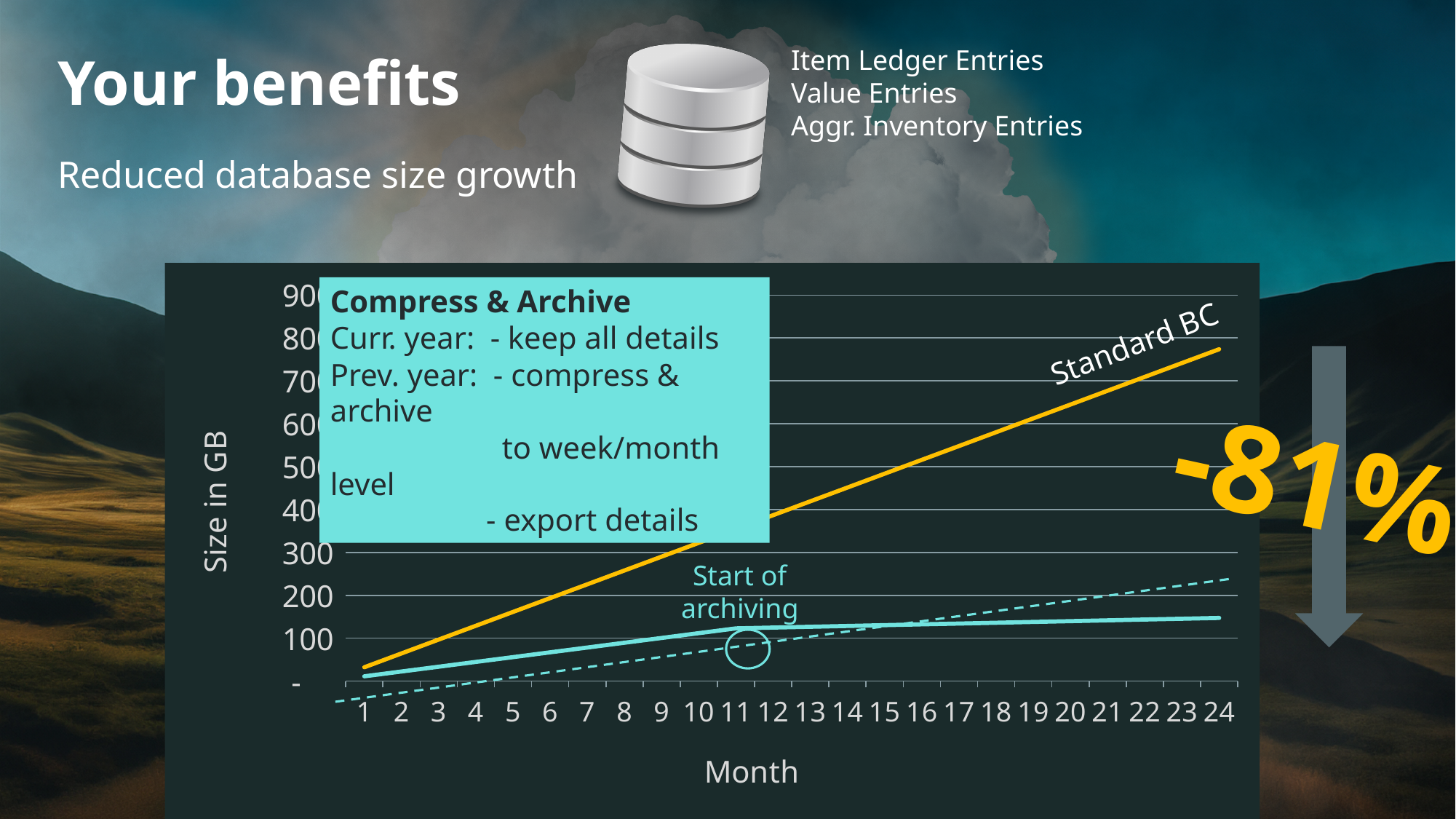
At month 24, which line is higher: Standard BC or Compress & Archive? Standard BC How many months are shown on the x axis of the chart? 24 Is the value of the Compress & Archive line at month 24 greater or less than 200? less Is the value of the Standard BC line at month 24 greater or less than 700? greater Is the value of the Standard BC line at month 1 greater or less than 100? less What is the label of the y axis of the chart? Size in GB What kind of chart is shown on the slide? line chart Does the Standard BC line rise or fall as the months increase? rise What is the label of the x axis of the chart? Month